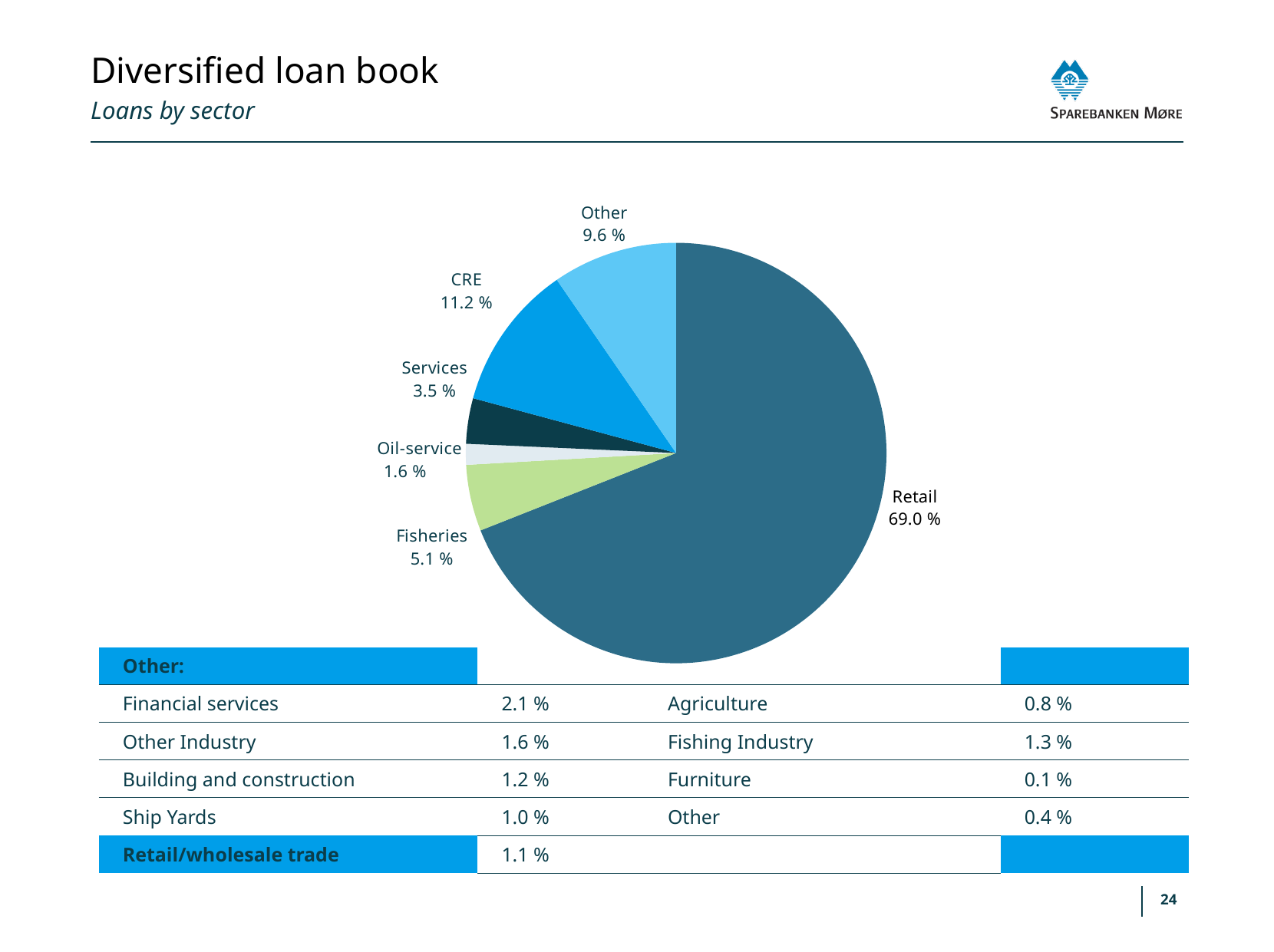
What share of loans is in Oil-service? 1.6 % What is the difference between the Retail share and the CRE share? 57.8 % Which sector has the largest share of the pie? Retail What is the difference between the Fisheries share and the Services share? 1.6 % How many slices does the pie chart have? 6 Which sector has the smallest share of the pie? Oil-service Which is larger, the share for CRE or the share for Other? CRE What is the subtitle of the chart on the slide? Loans by sector What share of loans is in Fisheries? 5.1 % What share of loans is in the Retail sector? 69.0 % What kind of chart is shown on the slide? Pie chart What share of loans is in CRE? 11.2 %